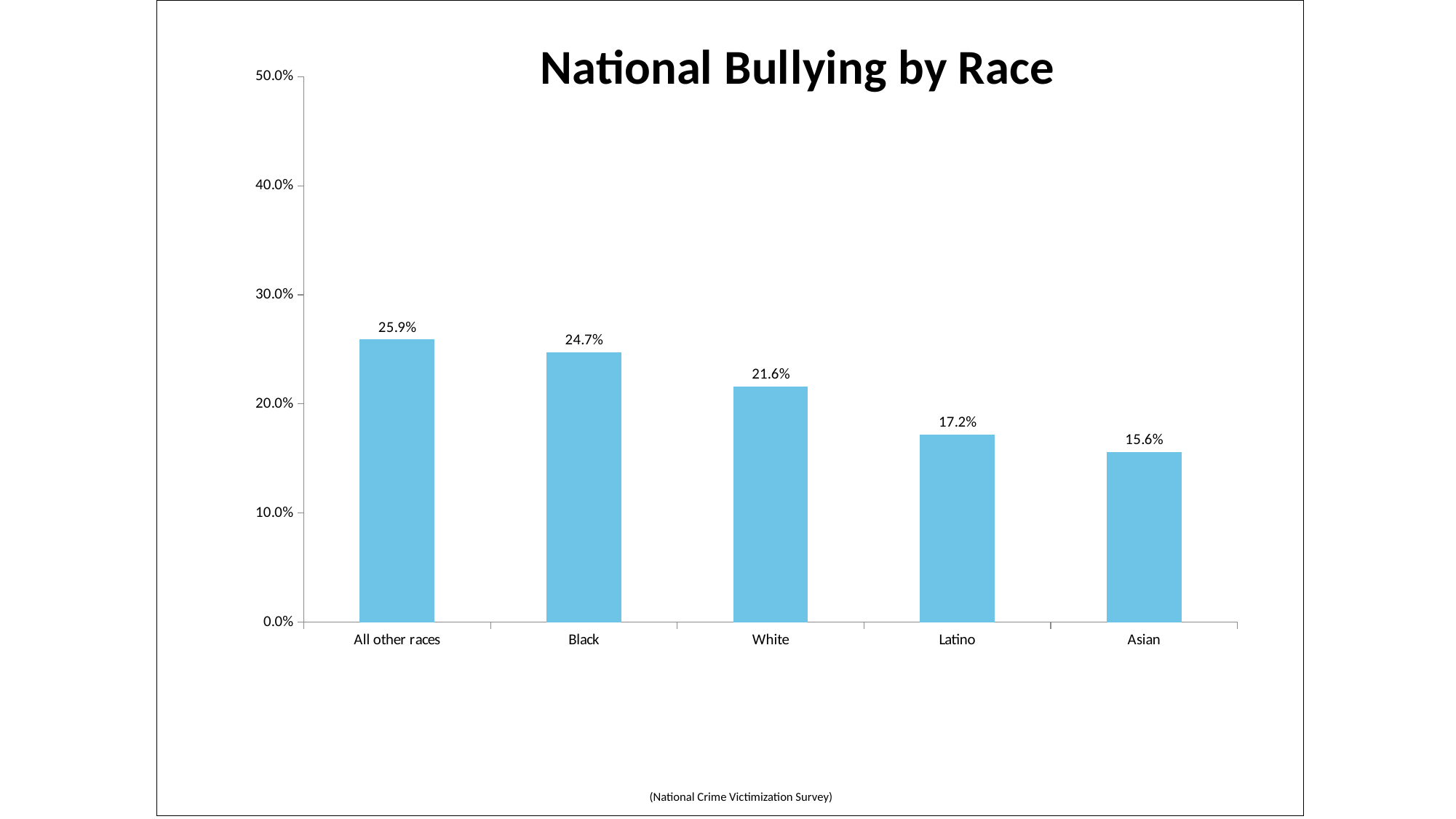
What is the value for Black? 24.7% What is the value for White? 21.6% What kind of chart is shown on the slide? Bar chart Which is larger, the value for Latino or the value for White? White Which category has the lowest value? Asian What is the difference between the values for White and Asian? 6.0% Is the value for Black greater or less than 20.0%? greater What is the value for Asian? 15.6% Which category has the highest value? All other races What is the difference between the values for All other races and Latino? 8.7% How many categories are shown on the x axis? 5 What is the title of the chart? National Bullying by Race